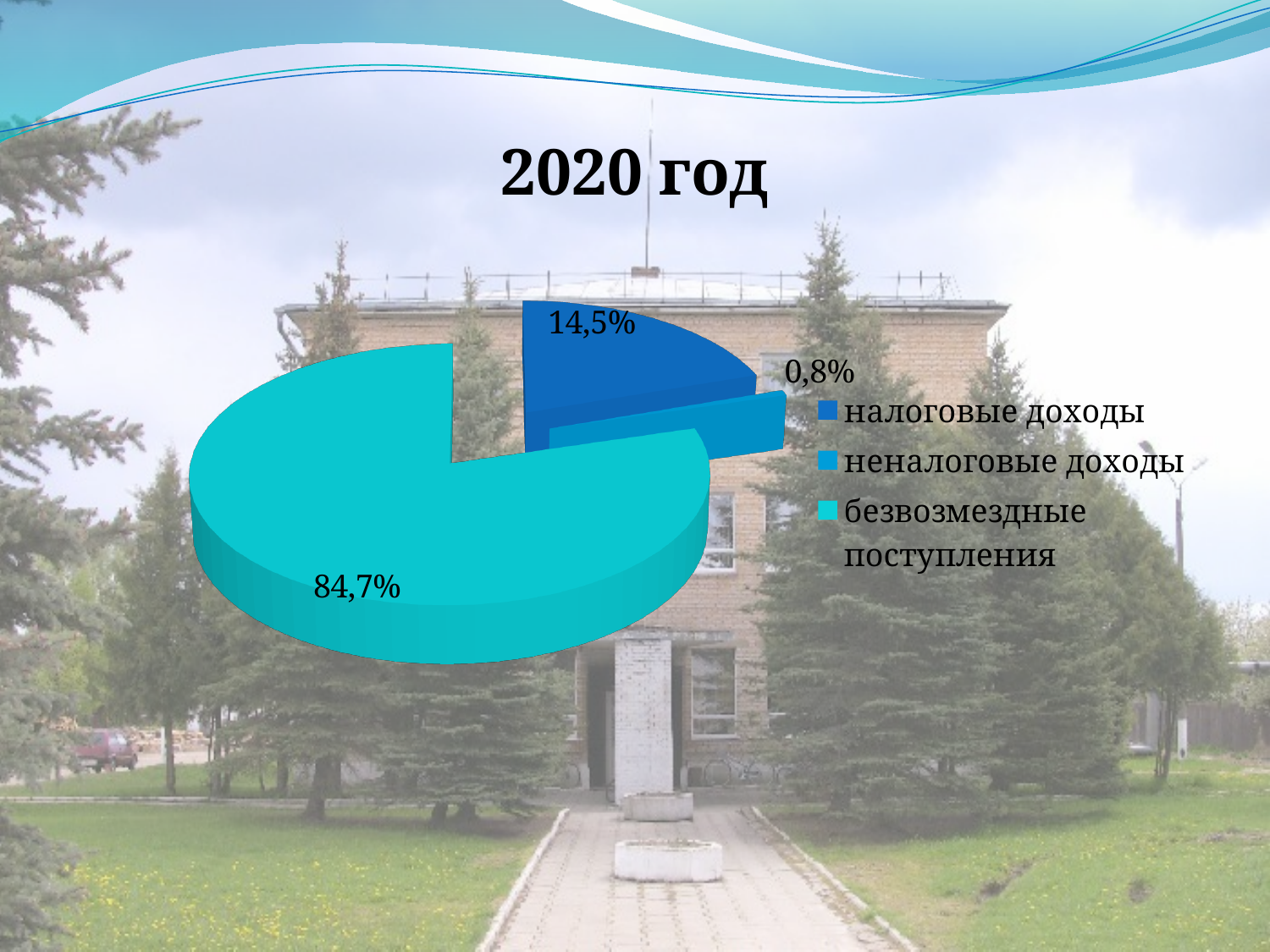
How many entries does the legend list? 3 Which category has the largest share of the pie? безвозмездные поступления What is the title of the chart? 2020 год What kind of chart is shown on the slide? pie chart What is the difference in percentage points between налоговые доходы and неналоговые доходы? 13,7 What share of the pie is налоговые доходы? 14,5% What share of the pie is неналоговые доходы? 0,8% How many slices does the pie chart have? 3 Which category has the smallest share of the pie? неналоговые доходы What is the difference in percentage points between безвозмездные поступления and налоговые доходы? 70,2 Which is larger, налоговые доходы or неналоговые доходы? налоговые доходы What share of the pie is безвозмездные поступления? 84,7%